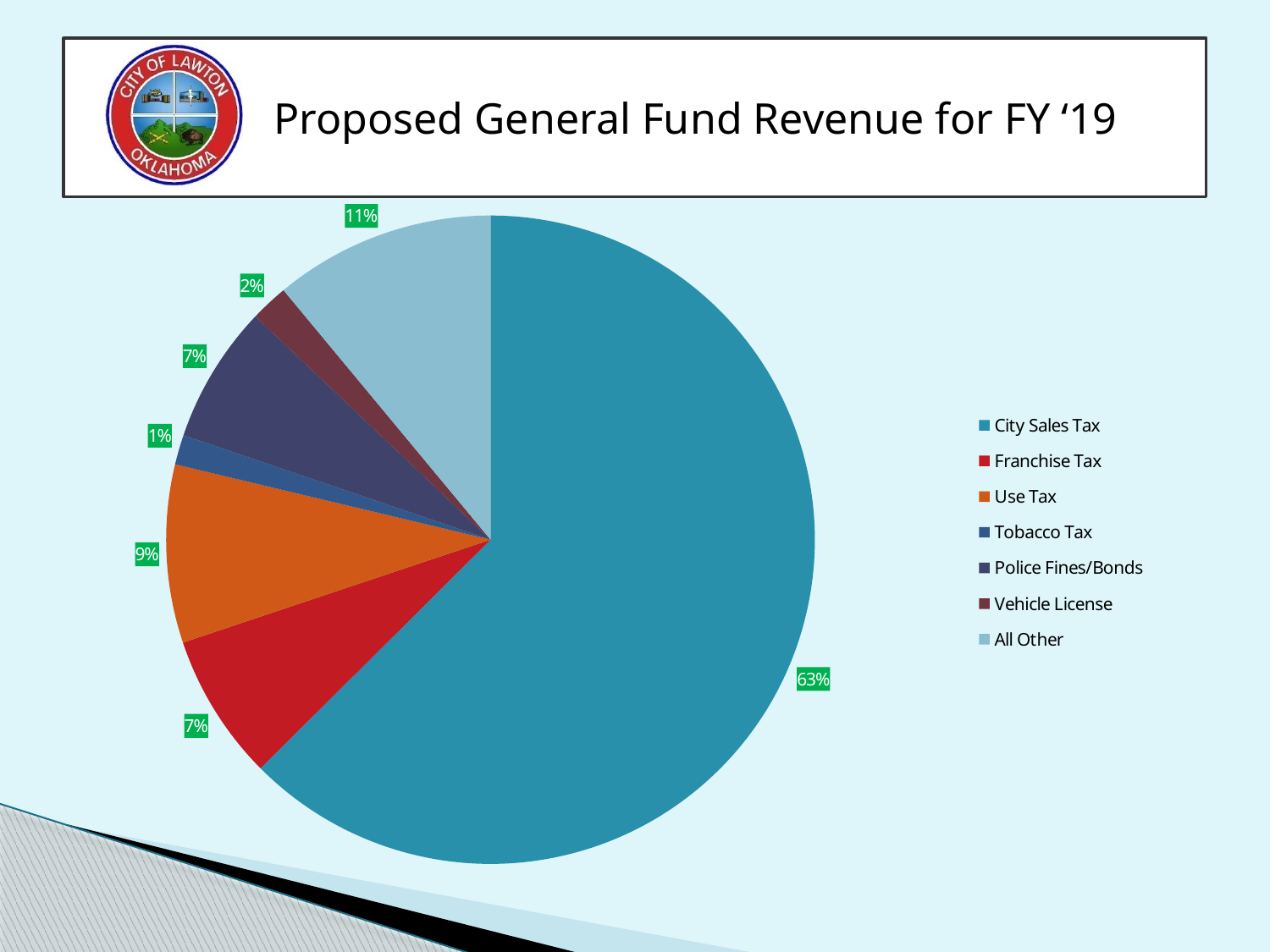
Which category has the smallest share of the pie? Tobacco Tax How many categories does the legend list? 7 What share of the pie does City Sales Tax represent? 63% What percentage is shown for Use Tax? 9% Which category has the largest share of the pie? City Sales Tax What is the title of the slide containing the chart? Proposed General Fund Revenue for FY '19 What percentage is shown for All Other? 11% What percentage is shown for Vehicle License? 2% What is the difference in percentage points between City Sales Tax and All Other? 52 What percentage is shown for Tobacco Tax? 1% What kind of chart is shown on the slide? Pie chart Which is larger, the share for Use Tax or the share for Franchise Tax? Use Tax